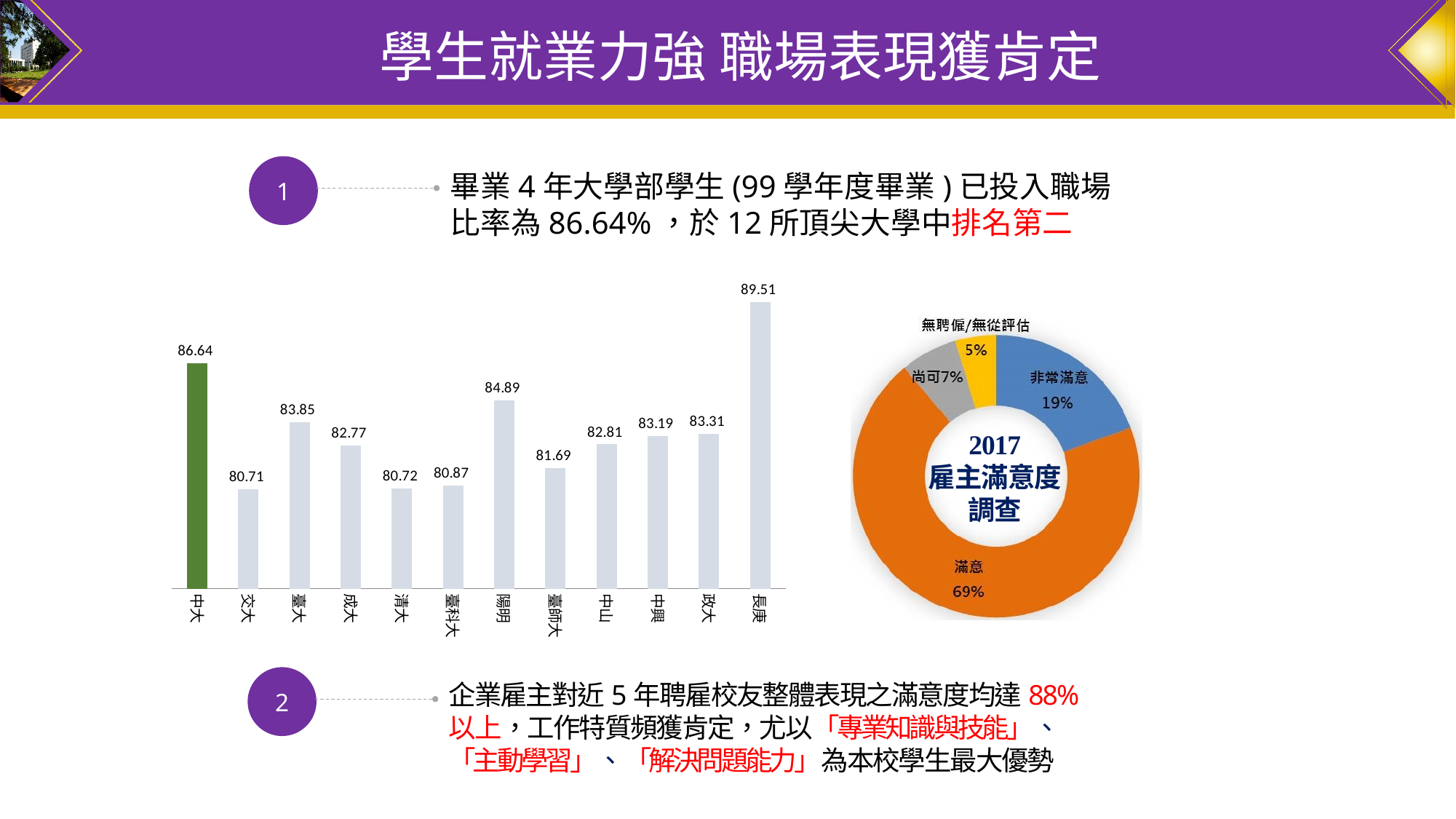
How many universities are shown in the bar chart on the left? 12 In the bar chart on the left, what is the value for 長庚? 89.51 In the bar chart on the left, what is the value for 中大? 86.64 In the bar chart on the left, which has a larger value, 臺大 or 成大? 臺大 In the bar chart on the left, what is the value for 陽明? 84.89 In the 2017 雇主滿意度調查 chart on the right, which category has the smallest share? 無聘僱/無從評估 In the bar chart on the left, which university has the highest value? 長庚 In the 2017 雇主滿意度調查 chart on the right, what share is 非常滿意? 19% In the bar chart on the left, what is the difference between the values for 長庚 and 中大? 2.87 In the bar chart on the left, which bar is coloured green? 中大 What kind of chart is the chart on the left? bar chart In the 2017 雇主滿意度調查 chart on the right, what share is 滿意? 69%